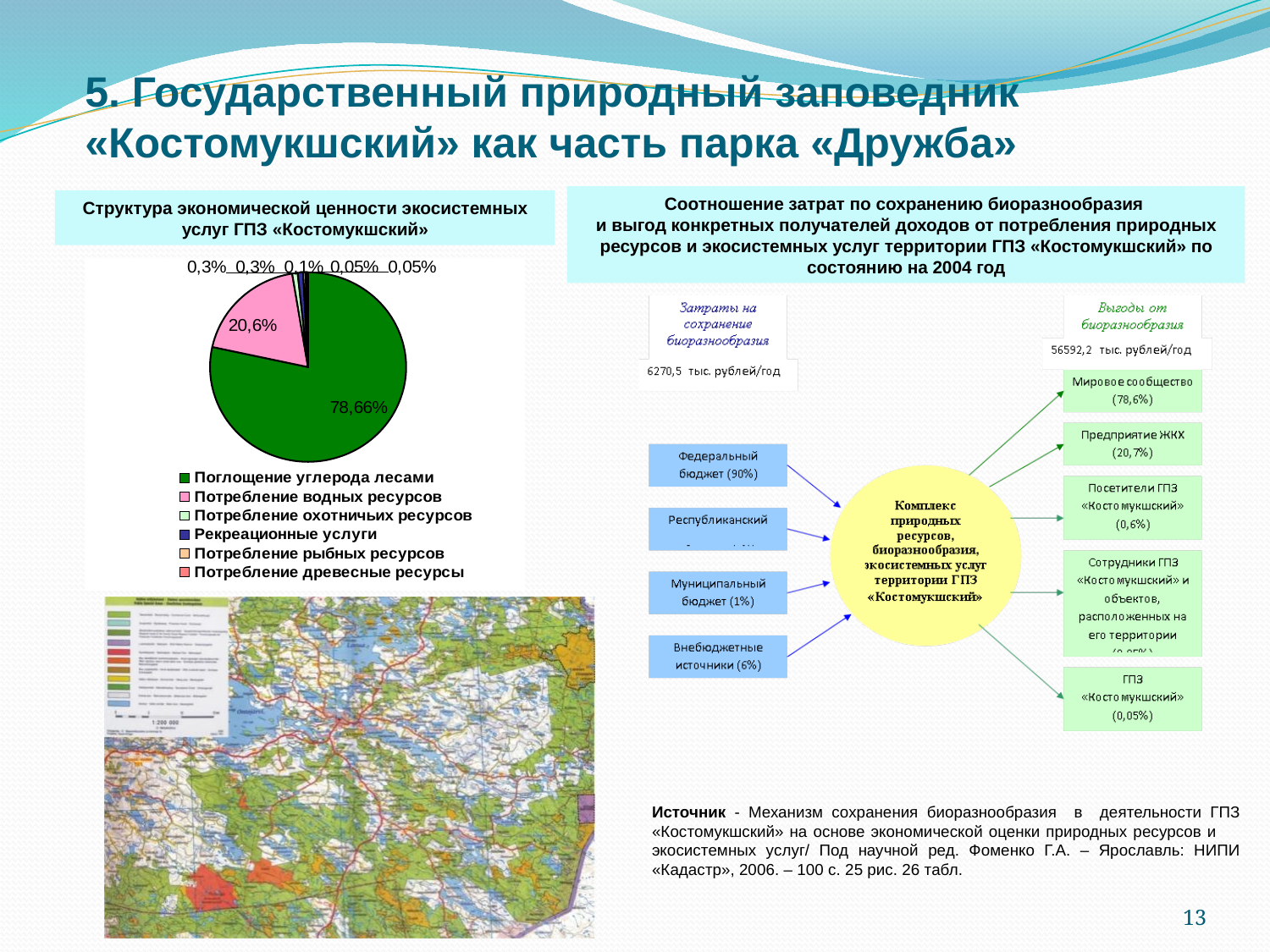
What colour is the slice for «Поглощение углерода лесами» in the pie chart? green In the pie chart, what share is shown for «Поглощение углерода лесами»? 78,66% How many entries does the legend of the pie chart list? 6 Which category has the largest slice in the pie chart? Поглощение углерода лесами In the pie chart, what share is shown for «Потребление водных ресурсов»? 20,6% What colour is the slice for «Потребление водных ресурсов» in the pie chart? pink What kind of chart is shown under the heading «Структура экономической ценности экосистемных услуг ГПЗ «Костомукшский»»? pie chart In the pie chart, which is larger: «Поглощение углерода лесами» or «Потребление водных ресурсов»? Поглощение углерода лесами What is the smallest percentage value labelled on the pie chart? 0,05% In the pie chart, what is the difference between the shares of «Поглощение углерода лесами» and «Потребление водных ресурсов»? 58,06% What is the largest percentage value labelled on the pie chart? 78,66%